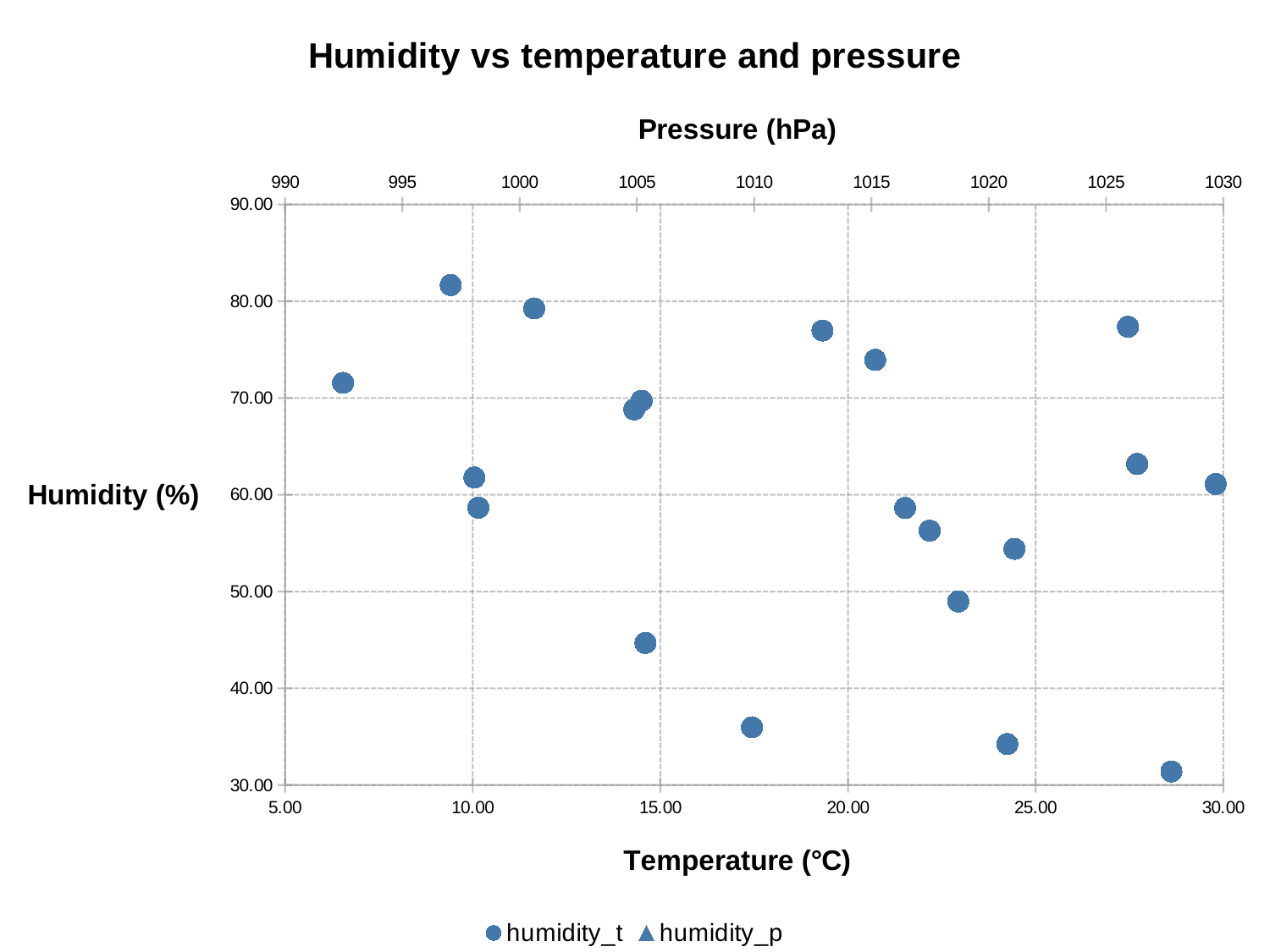
How many data points are plotted on the chart? 20 Is the humidity value of the point at about 28.6 °C greater or less than 40? less Is the highest humidity value plotted greater or less than 70? greater Is the humidity value of the point at about 17.4 °C greater or less than 40? less How many series does the legend list? 2 What kind of chart is shown on the slide? Scatter chart Which has the higher humidity: the point at about 9.3 °C or the point at about 14.6 °C? The point at about 9.3 °C What is the title of the chart? Humidity vs temperature and pressure What is the title of the bottom horizontal axis? Temperature (°C)